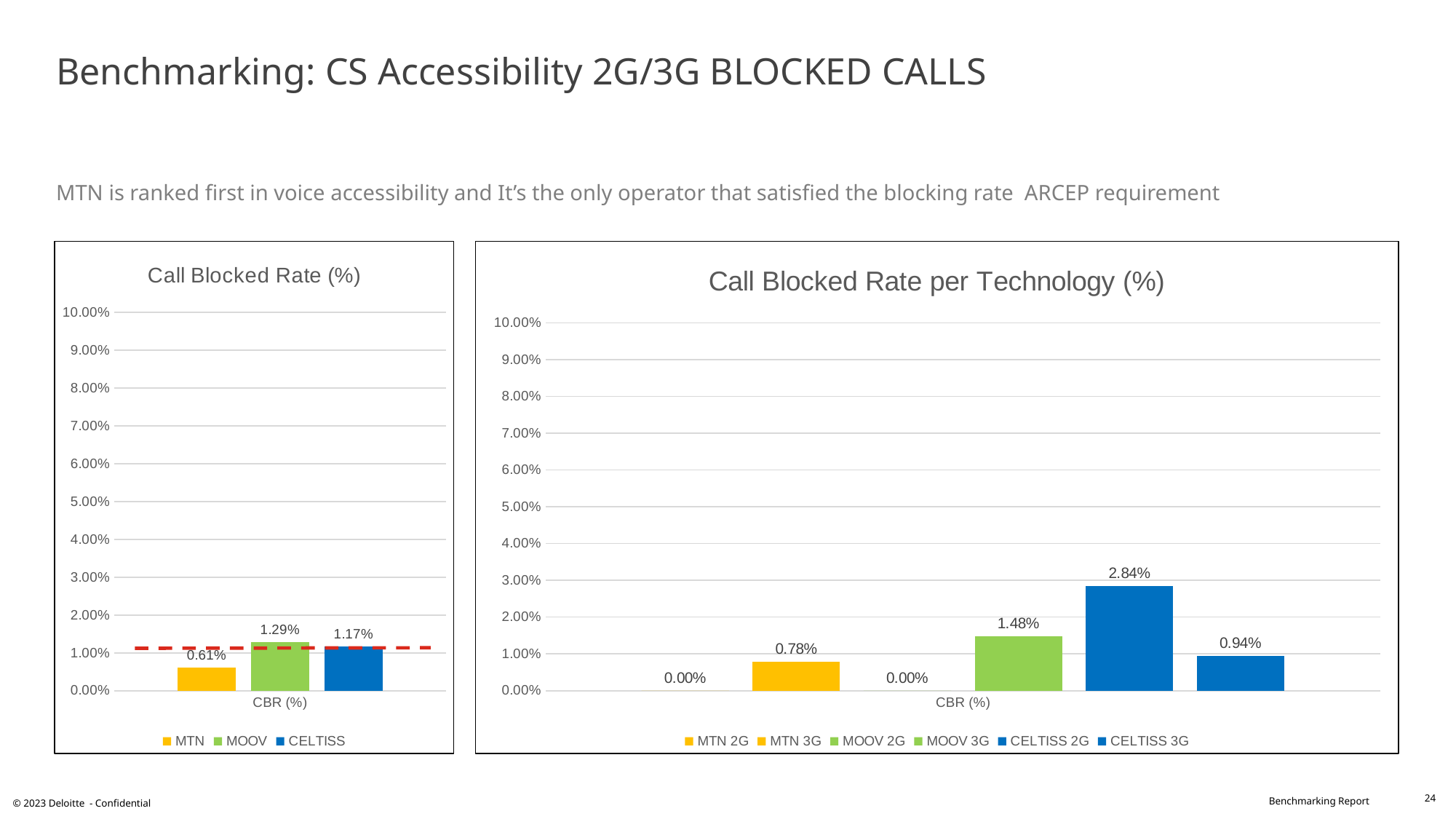
In the 'Call Blocked Rate per Technology (%)' chart, what is the value for MOOV 3G? 1.48% What type of chart is the 'Call Blocked Rate per Technology (%)' chart? Bar chart In the 'Call Blocked Rate (%)' chart, which operator has the highest call blocked rate? MOOV In the 'Call Blocked Rate per Technology (%)' chart, which is larger, MTN 3G or CELTISS 3G? CELTISS 3G In the 'Call Blocked Rate per Technology (%)' chart, what is the difference between CELTISS 2G and CELTISS 3G? 1.90% In the 'Call Blocked Rate (%)' chart, what is the value for MTN? 0.61% In the 'Call Blocked Rate (%)' chart, which operator has the lowest call blocked rate? MTN In the 'Call Blocked Rate (%)' chart, what is the value for MOOV? 1.29% In the 'Call Blocked Rate per Technology (%)' chart, which series has the highest value? CELTISS 2G In the 'Call Blocked Rate per Technology (%)' chart, what is the value for CELTISS 2G? 2.84% In the 'Call Blocked Rate (%)' chart, what is the difference between the MOOV and CELTISS values? 0.12% How many series does the legend of the 'Call Blocked Rate (%)' chart list? 3